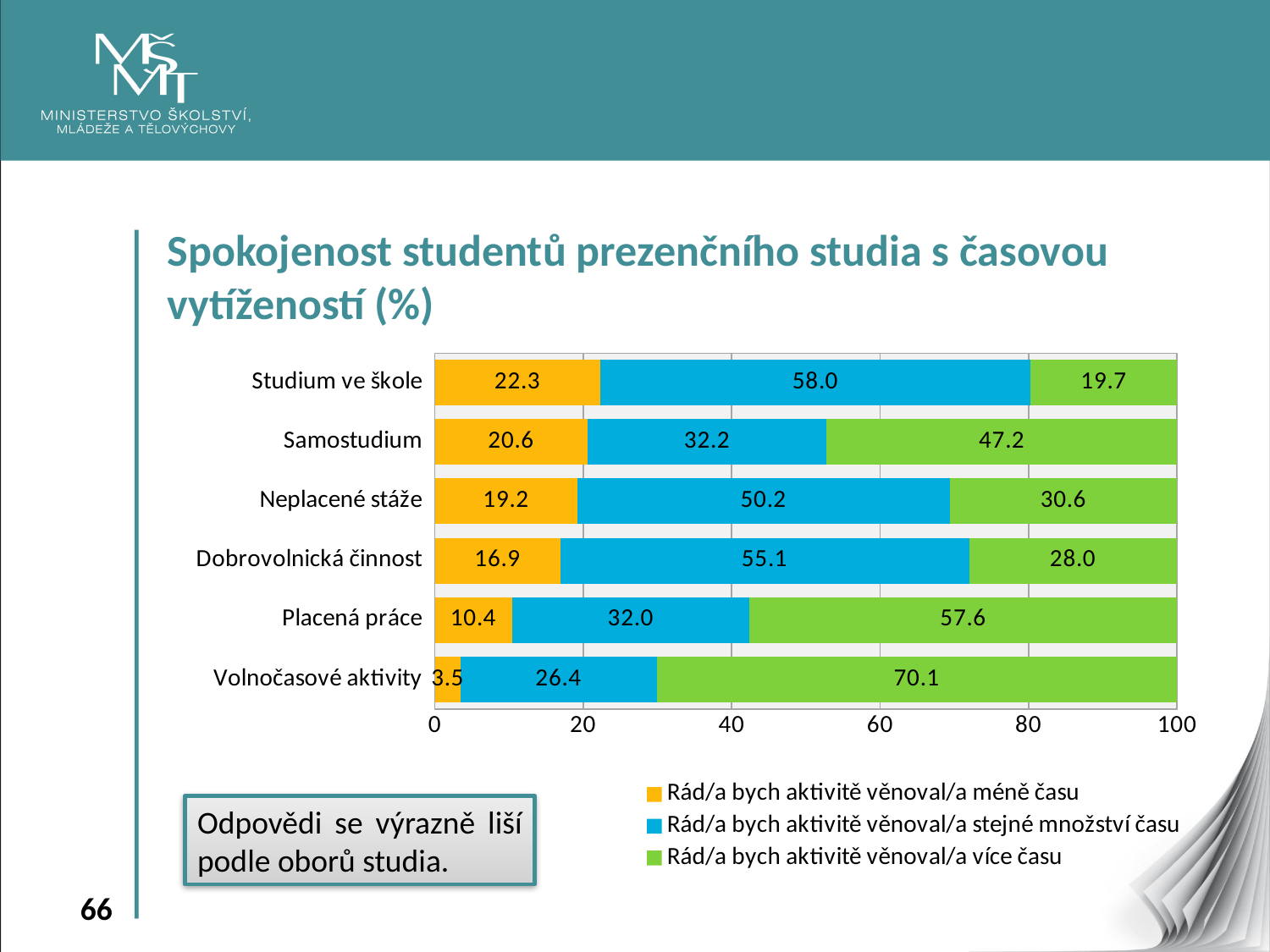
What kind of chart is shown on the slide? Stacked bar chart What is the value for 'Rád/a bych aktivitě věnoval/a více času' for Placená práce? 57.6 Which is larger: the 'více času' value for Samostudium or for Neplacené stáže? Samostudium What is the difference between the 'stejné množství času' values for Studium ve škole and Samostudium? 25.8 What is the value for 'Rád/a bych aktivitě věnoval/a méně času' for Neplacené stáže? 19.2 What is the value for 'Rád/a bych aktivitě věnoval/a stejné množství času' for Studium ve škole? 58.0 What is the total of the stacked bar for Dobrovolnická činnost? 100.0 Which category has the lowest value for 'Rád/a bych aktivitě věnoval/a méně času'? Volnočasové aktivity What is the title of the chart? Spokojenost studentů prezenčního studia s časovou vytížeností (%) How many categories are shown on the chart? 6 How many series does the legend list? 3 Which category has the highest value for 'Rád/a bych aktivitě věnoval/a více času'? Volnočasové aktivity